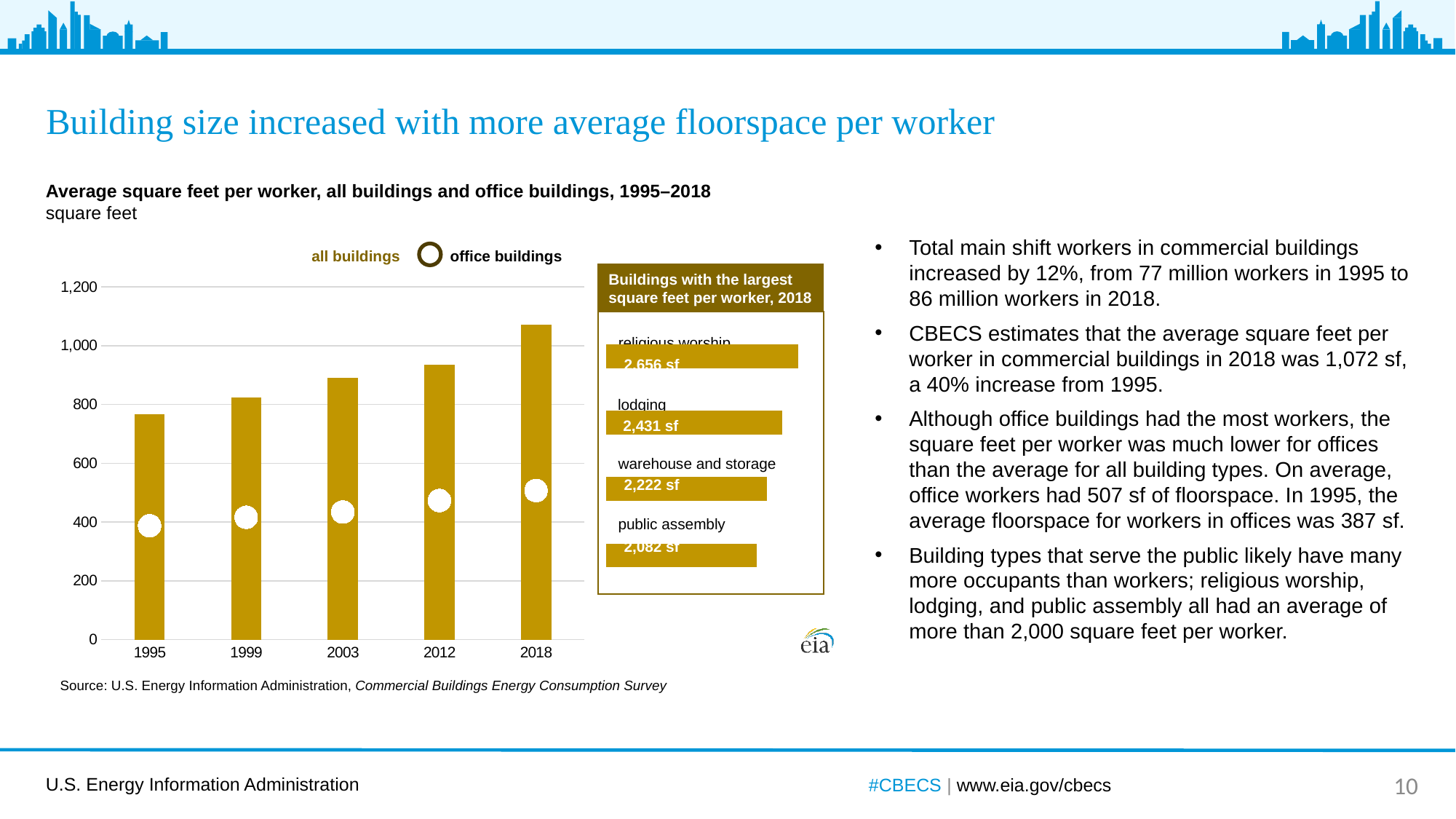
In the main chart, which year has the lowest 'all buildings' value? 1995 In the inset chart 'Buildings with the largest square feet per worker, 2018', what is the value for lodging? 2,431 sf In the main chart, do the 'all buildings' values rise or fall from 1995 to 2018? rise In the inset chart 'Buildings with the largest square feet per worker, 2018', which building type has the highest value? religious worship In the main chart, for 2018, which is larger: the 'all buildings' value or the 'office buildings' value? all buildings In the main chart, is the 'all buildings' value for 2018 greater or less than 1,000? greater In the main chart, is the 'all buildings' value for 1995 greater or less than 800? less In the inset chart 'Buildings with the largest square feet per worker, 2018', what is the difference between religious worship and public assembly? 574 sf In the main chart, which year has the highest 'all buildings' value? 2018 In the main chart, how many series does the legend list? 2 What kind of chart is the main chart titled 'Average square feet per worker, all buildings and office buildings, 1995–2018'? combination bar and line chart (bars with circle markers) In the main chart, how many years are shown on the x axis? 5